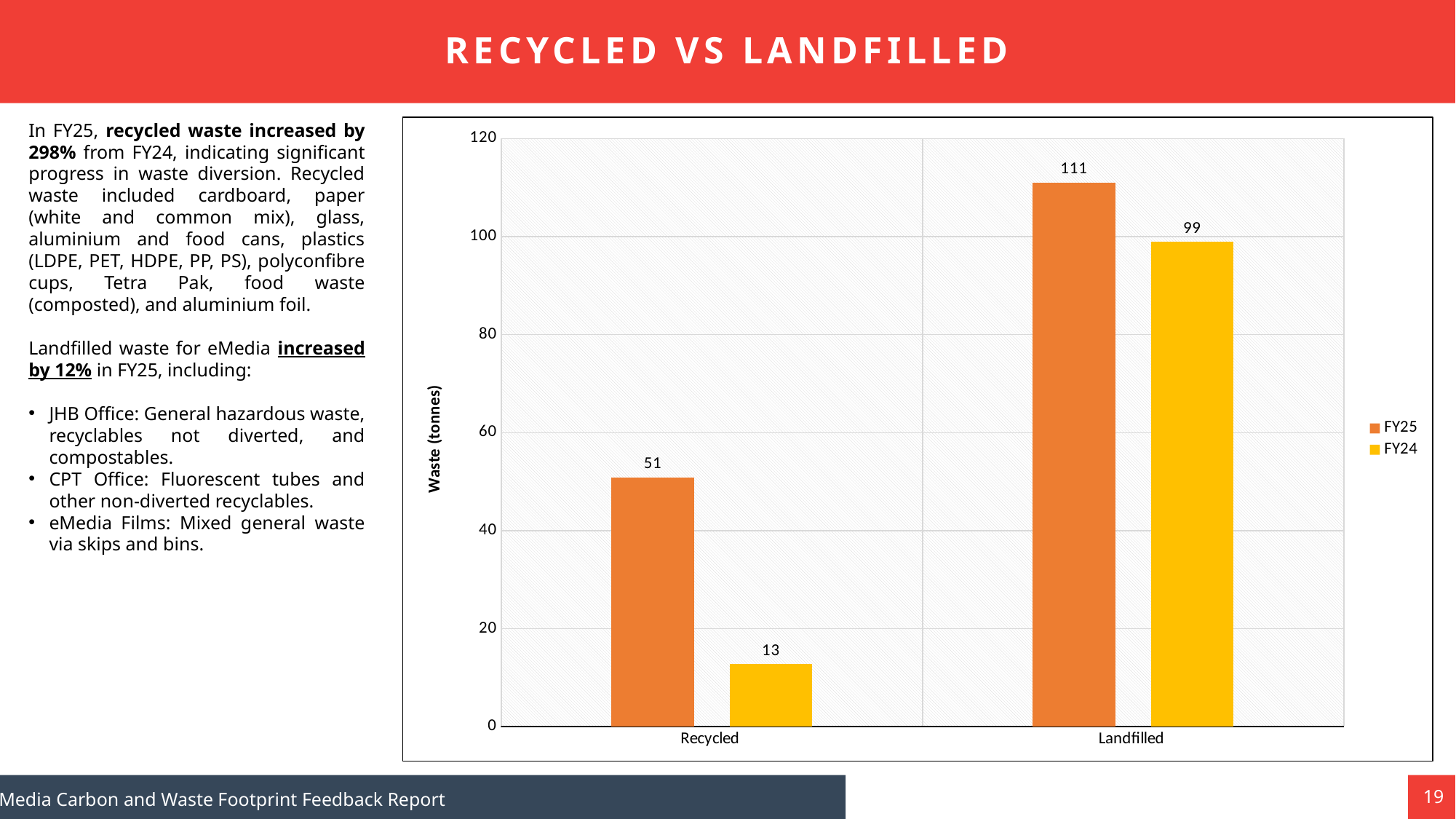
Which category has the highest FY25 value? Landfilled What is the difference between the FY25 and FY24 values for Recycled waste? 38 What is the difference between the FY25 and FY24 values for Landfilled waste? 12 Which is larger, the FY25 value for Recycled or the FY24 value for Landfilled? FY24 value for Landfilled What is the FY25 value for Recycled waste? 51 What is the FY24 value for Recycled waste? 13 What is the FY25 value for Landfilled waste? 111 What type of chart is shown on the slide? Bar chart What is the FY24 value for Landfilled waste? 99 How many categories are shown on the x axis? 2 Which category has the lowest FY24 value? Recycled How many series does the legend list? 2